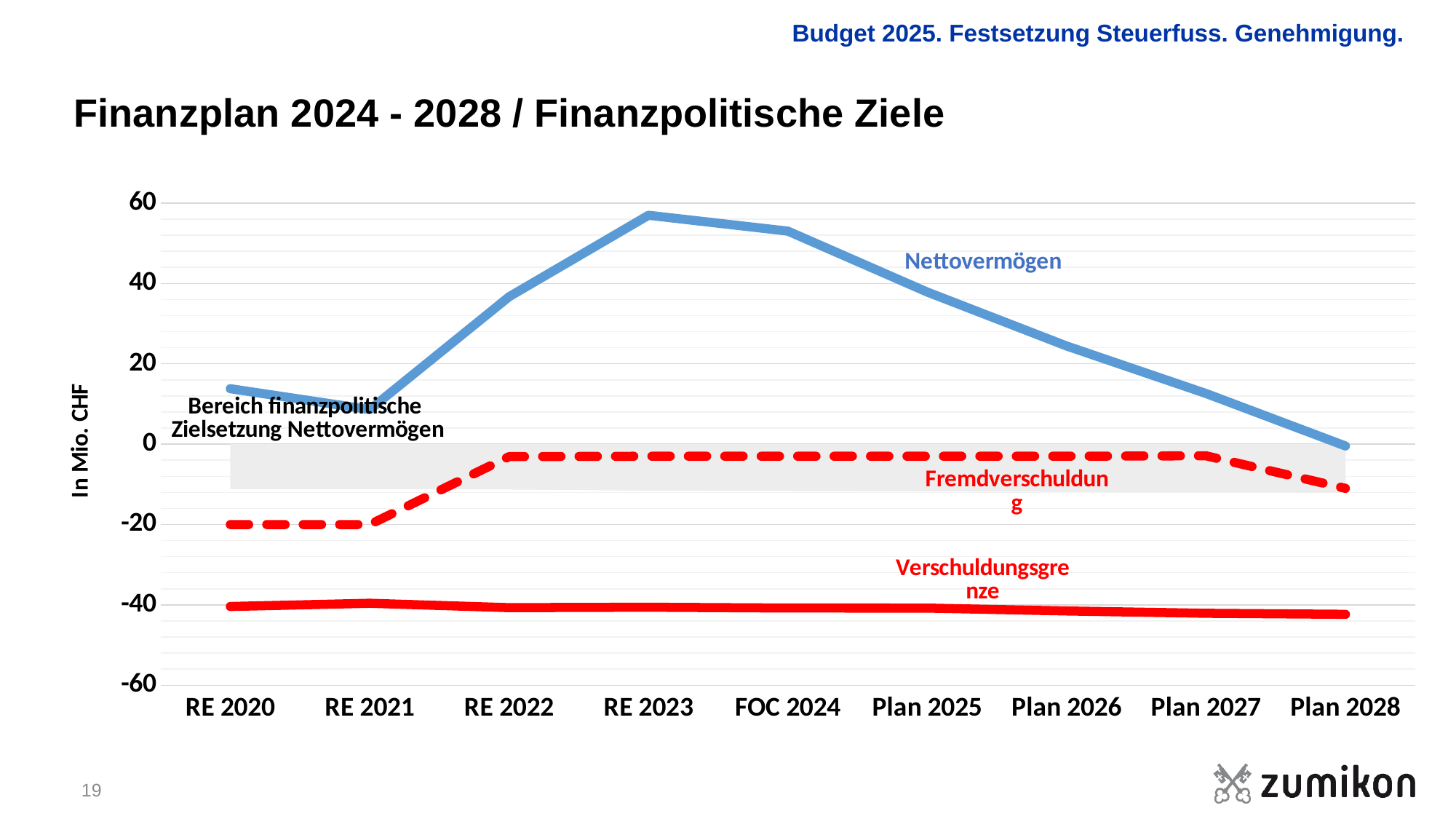
Does Nettovermögen rise or fall from RE 2023 to Plan 2028? fall Is the value of Nettovermögen at RE 2023 greater or less than 40? greater What kind of chart is shown on the slide? line chart Is the value of Verschuldungsgrenze at Plan 2028 greater or less than -20? less At which time point is Nettovermögen at its lowest value? Plan 2028 Which is higher: Nettovermögen at RE 2023 or at FOC 2024? RE 2023 Is the value of Fremdverschuldung at RE 2020 greater or less than 0? less At which time point does Nettovermögen reach its highest value? RE 2023 What unit is given on the y axis of the chart? In Mio. CHF How many time points are shown on the x axis of the chart? 9